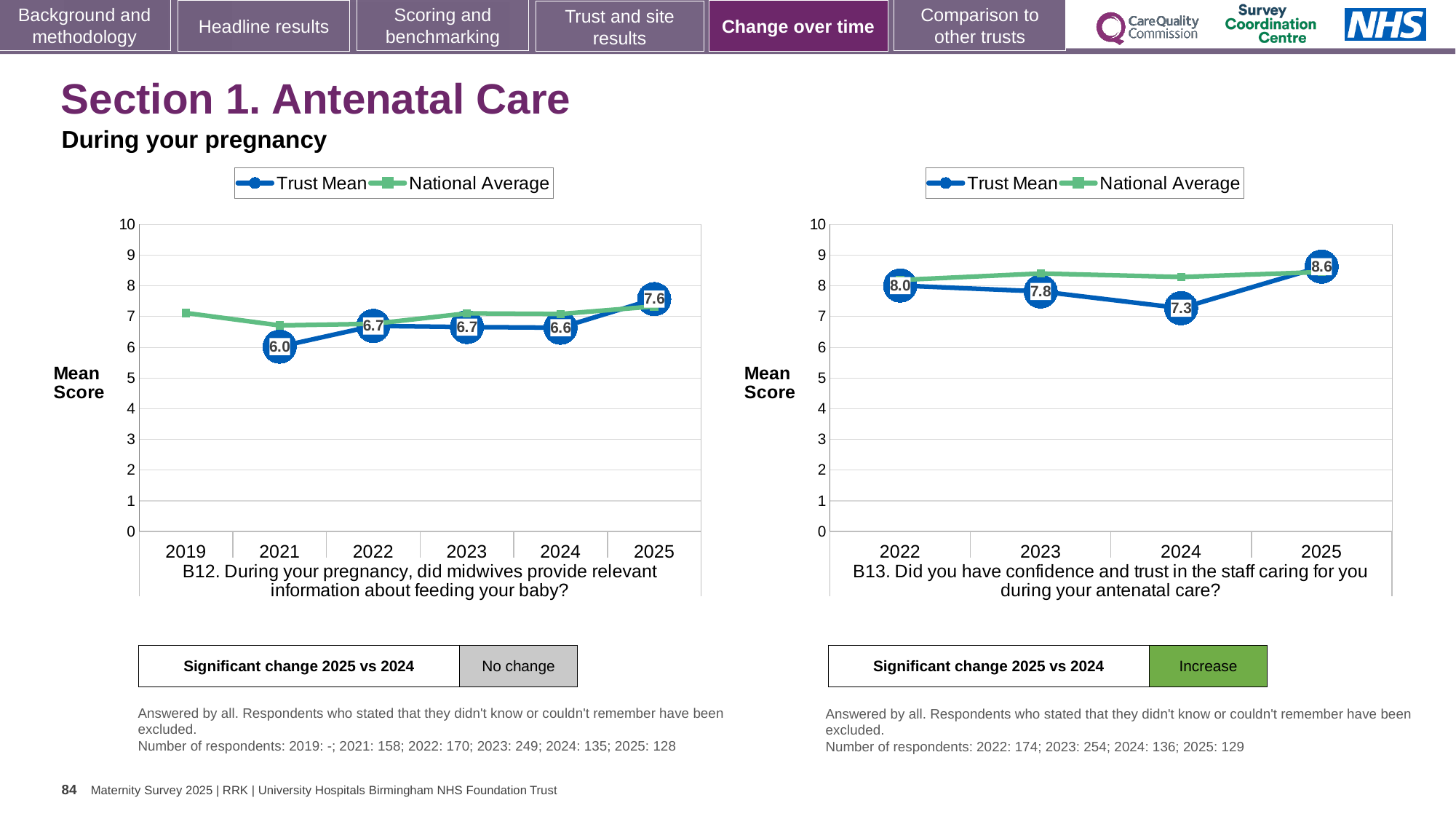
In the B13 chart (right), what is the difference between the Trust Mean for 2025 and for 2024? 1.3 How many years are shown on the x axis of the B13 chart (right)? 4 In the B13 chart (right), which year has the highest Trust Mean? 2025 In the B12 chart (left), is the National Average for 2019 greater or less than 6? greater In the B12 chart (left), which year has the lowest Trust Mean? 2021 In the B12 chart (left), what is the Trust Mean for 2025? 7.6 In the B12 chart (left), what is the Trust Mean for 2021? 6.0 In the B13 chart (right), does the Trust Mean rise or fall from 2022 to 2024? Fall What type of chart is the B13 chart (right)? Line chart How many series does the legend of the B12 chart (left) list? 2 In the B12 chart (left), is the Trust Mean higher in 2025 or in 2024? 2025 In the B13 chart (right), what is the Trust Mean for 2024? 7.3